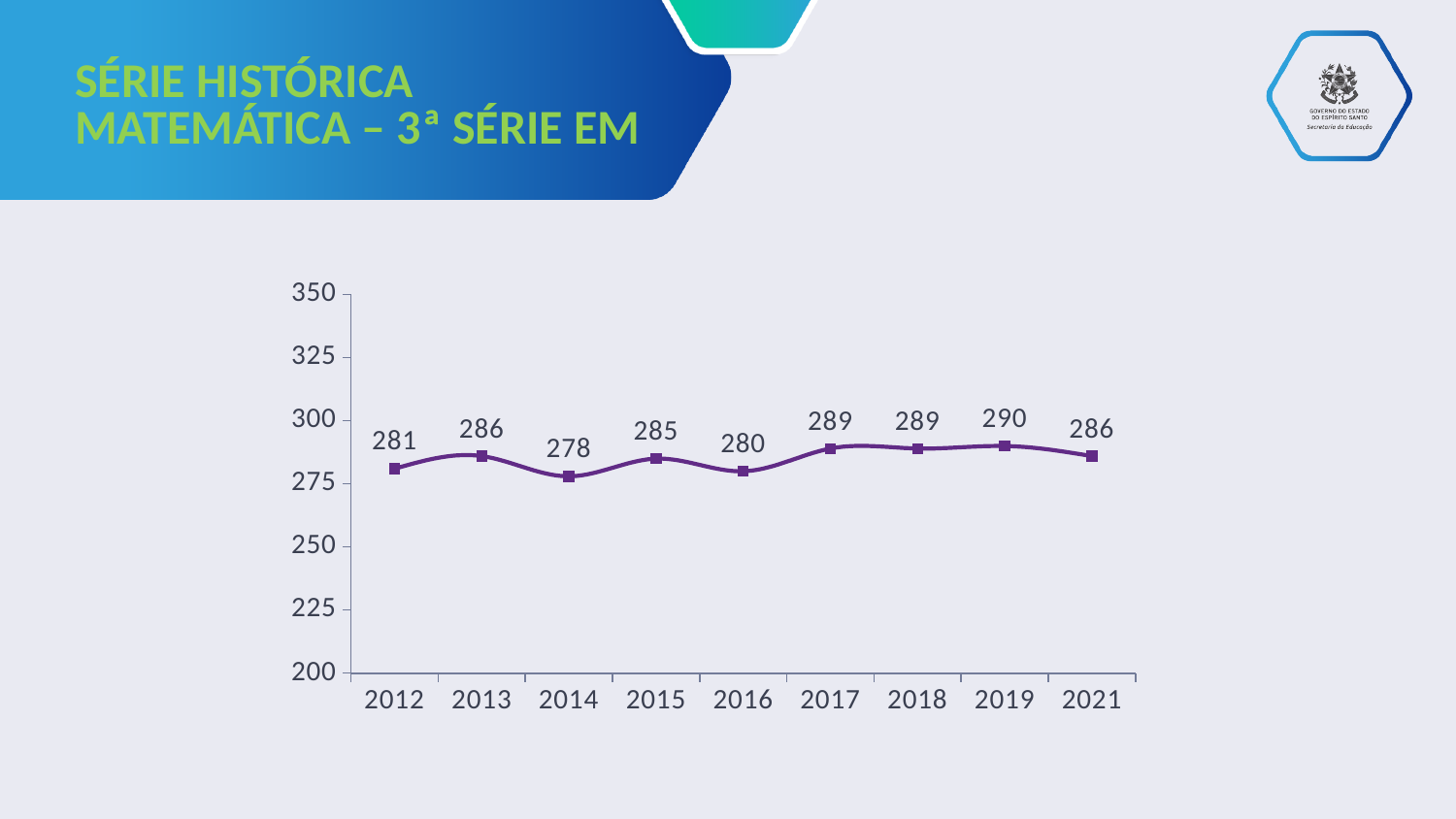
What is the value for 2012? 281 Which year has the lowest value? 2014 What is the difference between the values for 2019 and 2014? 12 Which is larger, the value for 2013 or the value for 2016? 2013 What is the value for 2021? 286 Does the value rise or fall from 2016 to 2017? rise What is the title of the slide? SÉRIE HISTÓRICA MATEMÁTICA – 3ª SÉRIE EM How many years are plotted on the x axis? 9 What is the value for 2014? 278 What kind of chart is shown on the slide? line chart Which year has the highest value? 2019 Is the value for 2017 greater or less than 275? greater